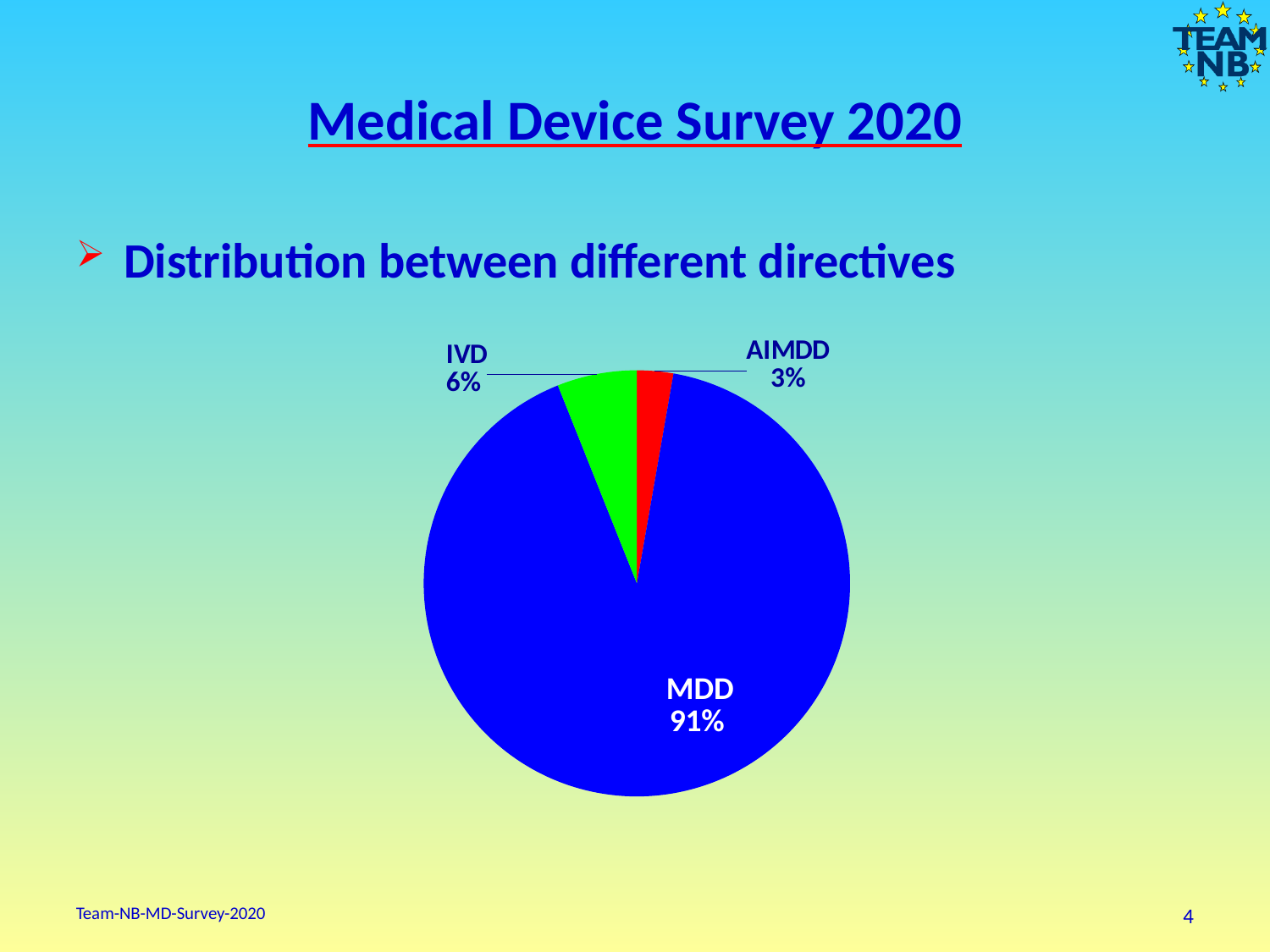
What share of the pie does AIMDD represent? 3% Which directive has the smallest slice of the pie? AIMDD What share of the pie does IVD represent? 6% What kind of chart is shown on the slide? pie chart What is the difference in percentage points between the MDD and IVD slices? 85 How many slices does the pie chart have? 3 What share of the pie does MDD represent? 91% What colour is the IVD slice of the pie? green Which directive has the largest slice of the pie? MDD Which slice is larger, IVD or AIMDD? IVD What colour is the MDD slice of the pie? blue What is the difference in percentage points between the IVD and AIMDD slices? 3